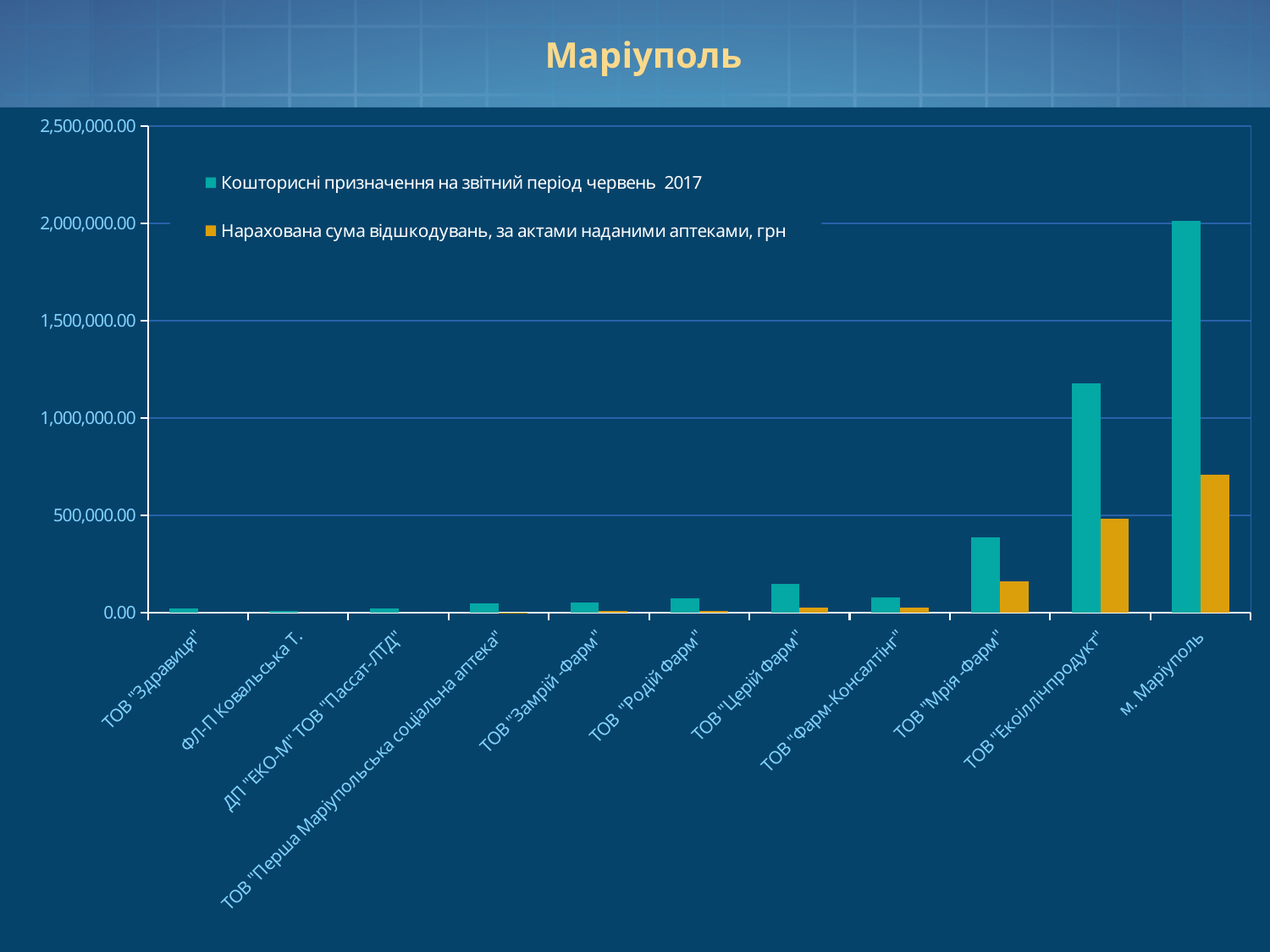
Which category has the highest value for "Нарахована сума відшкодувань, за актами наданими аптеками, грн"? м. Маріуполь What is the title of the chart? Маріуполь For ТОВ "Мрія-Фарм", which series has the larger value: "Кошторисні призначення на звітний період червень 2017" or "Нарахована сума відшкодувань, за актами наданими аптеками, грн"? Кошторисні призначення на звітний період червень 2017 Which category has the highest value for "Кошторисні призначення на звітний період червень 2017"? м. Маріуполь Which series is shown in orange in the legend? Нарахована сума відшкодувань, за актами наданими аптеками, грн How many series does the legend list? 2 What kind of chart is shown on the slide? bar chart Is the value of "Кошторисні призначення на звітний період червень 2017" for ТОВ "Екоіллічпродукт" greater or less than 1,000,000.00? greater Is the value of "Нарахована сума відшкодувань, за актами наданими аптеками, грн" for м. Маріуполь greater or less than 500,000.00? greater How many categories are shown on the x axis? 11